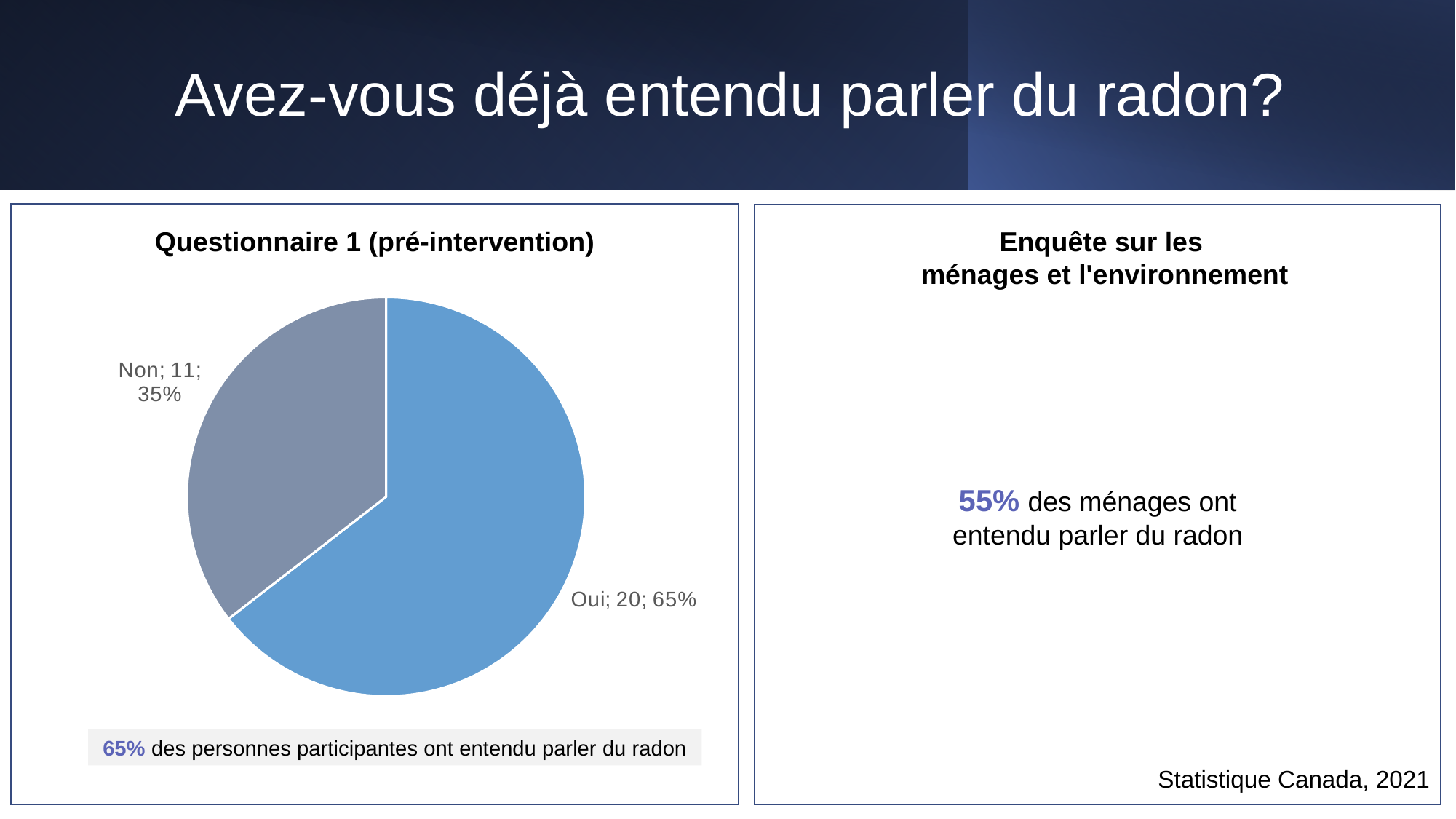
What is the difference between the counts for "Oui" and "Non" in the pie chart? 9 What share of the pie does the "Non" slice represent? 35% What is the total of the counts shown in the pie chart? 31 What is the count for "Non" in the pie chart? 11 What share of the pie does the "Oui" slice represent? 65% What is the count for "Oui" in the pie chart? 20 Which slice of the pie chart is the smallest? Non What kind of chart is shown under the title "Questionnaire 1 (pré-intervention)"? pie chart Which slice of the pie chart is the largest? Oui Which is larger in the pie chart, the count for "Oui" or the count for "Non"? Oui What is the title of the pie chart? Questionnaire 1 (pré-intervention) How many slices does the pie chart have? 2